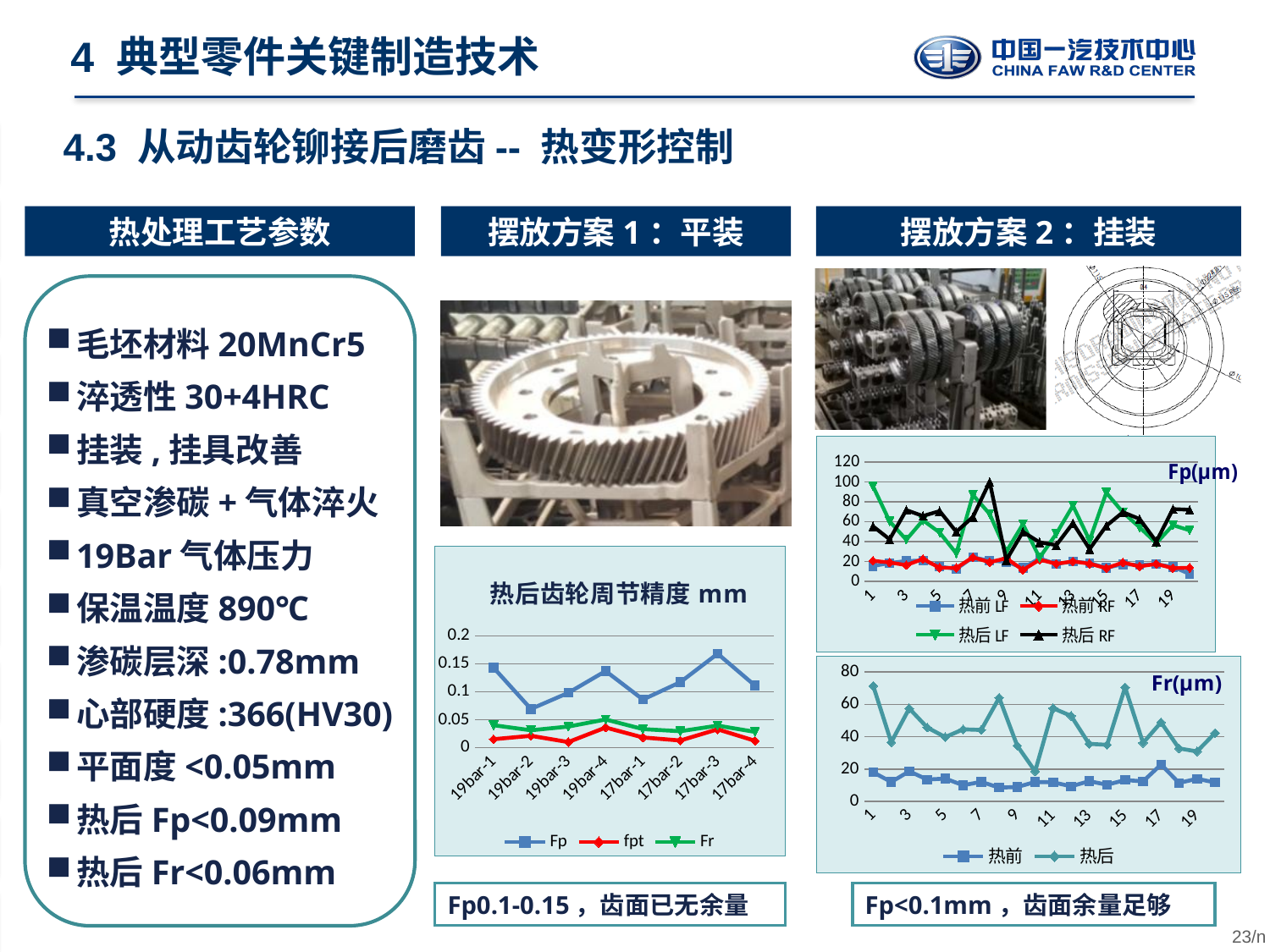
In the "热后齿轮周节精度 mm" chart, which series is larger at 19bar-1, Fp or Fr? Fp In the "热后齿轮周节精度 mm" chart, is the Fp value for 19bar-2 greater or less than 0.1? less In the "Fr(μm)" chart, is the 热后 value at point 1 greater or less than 60? greater In the "Fr(μm)" chart, which series is larger at point 1, 热前 or 热后? 热后 How many categories are on the x axis of the "热后齿轮周节精度 mm" chart? 8 How many series does the legend of the "Fr(μm)" chart list? 2 How many series does the legend of the "Fp(μm)" chart list? 4 In the "热后齿轮周节精度 mm" chart, which category has the highest Fp value? 17bar-3 How many series does the legend of the "热后齿轮周节精度 mm" chart list? 3 In the "热后齿轮周节精度 mm" chart, which category has the lowest Fp value? 19bar-2 In the "热后齿轮周节精度 mm" chart, is the Fp value for 17bar-3 greater or less than 0.15? greater What type of chart is the "热后齿轮周节精度 mm" chart? line chart